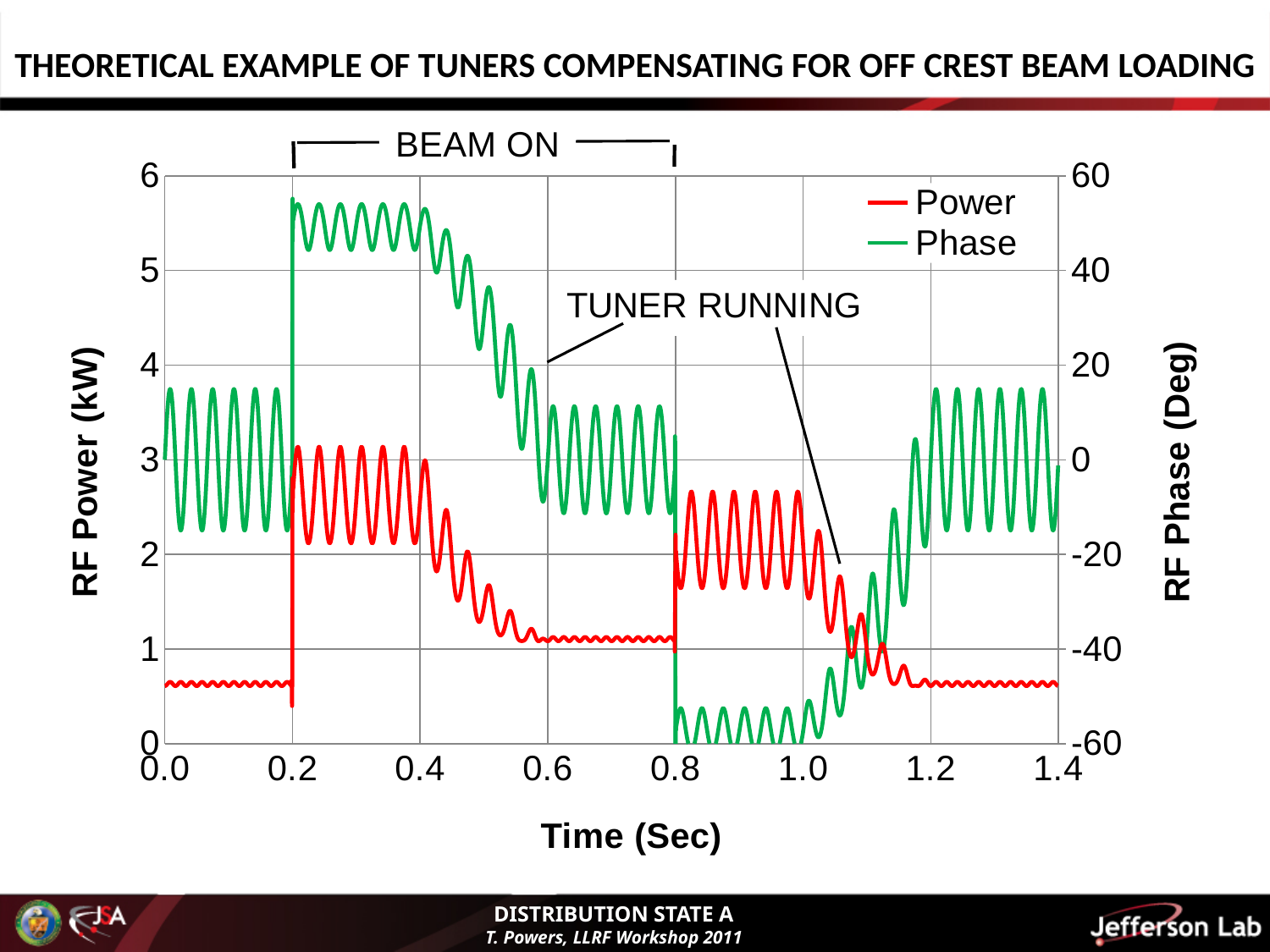
What colour is the Power line? red What kind of chart is shown on the slide? line chart Is the Phase value at time 0.3 sec greater or less than 40 degrees? greater Does the Power line rise or fall between 0.4 sec and 0.6 sec? fall Which series is higher at time 0.3 sec on its own axis scale, Power (kW) or Phase (Deg), in terms of the Power line being above or below the Phase line on the plot? Phase Is the Phase value at time 0.9 sec greater or less than -40 degrees? less How many series does the legend list? 2 Is the Power value at time 0.1 sec greater or less than 1 kW? less What are the two series named in the legend? Power and Phase Does the Phase line rise or fall between 1.0 sec and 1.2 sec? rise